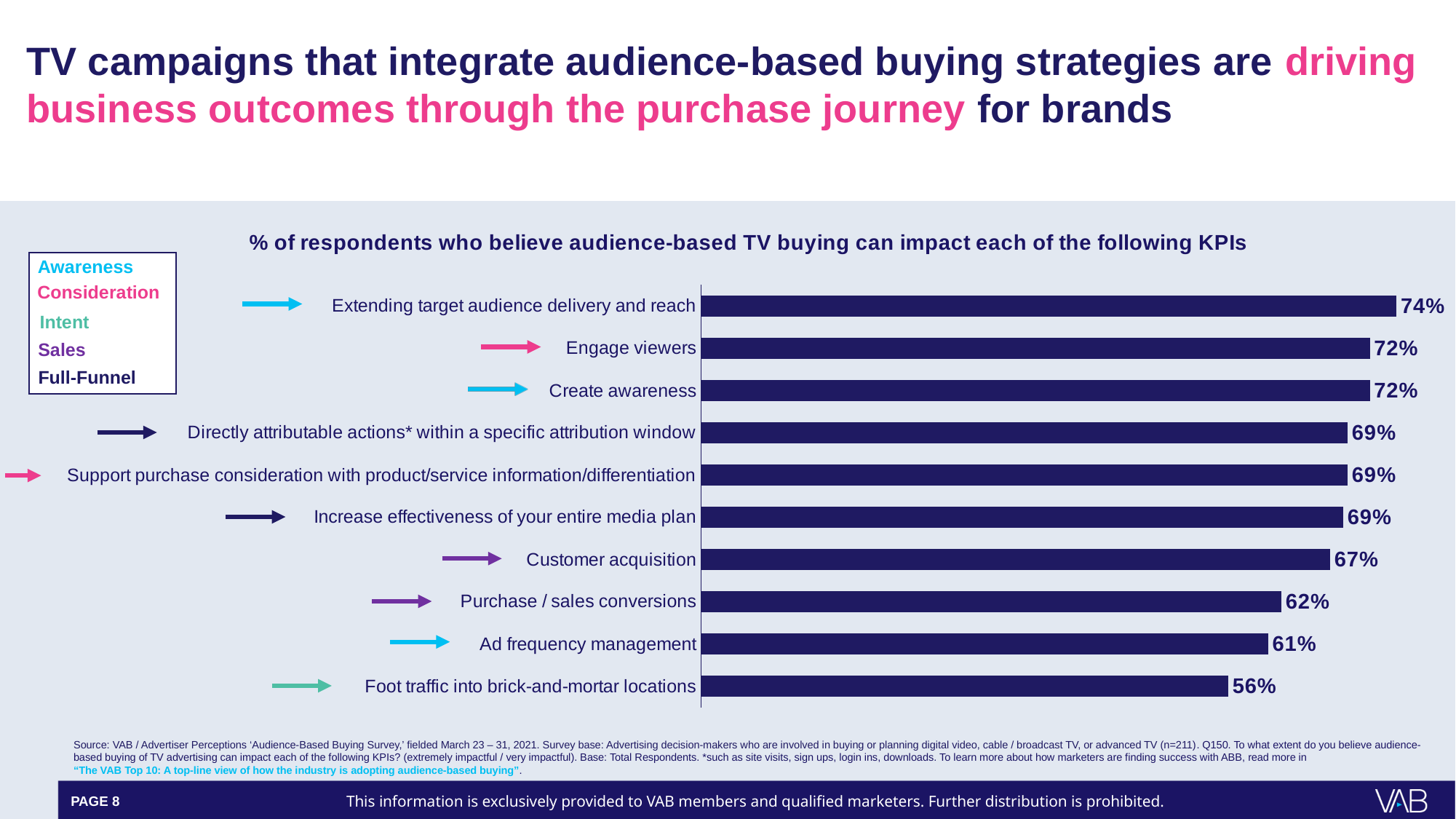
What percentage of respondents believe audience-based TV buying can impact extending target audience delivery and reach? 74% What is the value shown for Foot traffic into brick-and-mortar locations? 56% What is the difference between the values for Customer acquisition and Purchase / sales conversions? 5% Which KPI has the lowest percentage of respondents? Foot traffic into brick-and-mortar locations What is the value shown for Ad frequency management? 61% What is the value shown for Customer acquisition? 67% Which is larger, the value for Engage viewers or the value for Ad frequency management? Engage viewers What is the difference between the values for Extending target audience delivery and reach and Foot traffic into brick-and-mortar locations? 18% Which KPI has the highest percentage of respondents? Extending target audience delivery and reach What is the title of the chart? % of respondents who believe audience-based TV buying can impact each of the following KPIs How many KPIs are plotted in the chart? 10 What kind of chart is shown on the slide? Bar chart